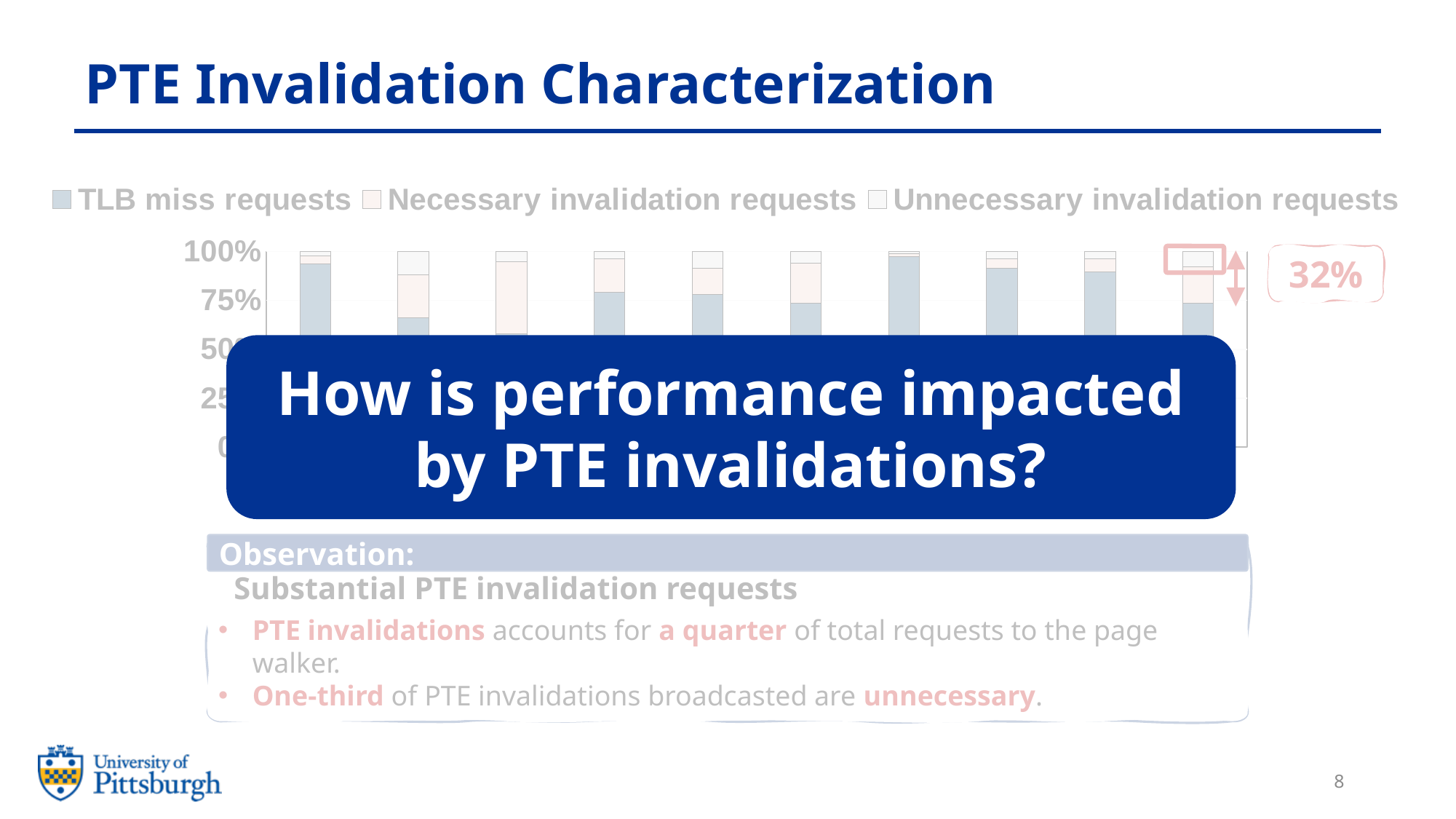
What percentage is annotated in red next to the rightmost bar of the chart? 32% Is the TLB miss requests share of the rightmost bar greater or less than 100%? less How many bars are plotted in the chart? 10 What are the three series named in the chart legend? TLB miss requests, Necessary invalidation requests, Unnecessary invalidation requests Is the TLB miss requests share of the first (leftmost) bar greater or less than 75%? greater What kind of chart is shown on the slide? Stacked bar chart How many series does the chart legend list? 3 Is the TLB miss requests share of the second bar from the left greater or less than 75%? less Which bar has a larger TLB miss requests share: the first bar from the left or the second bar from the left? The first bar from the left What is the highest value labelled on the chart's y axis? 100%